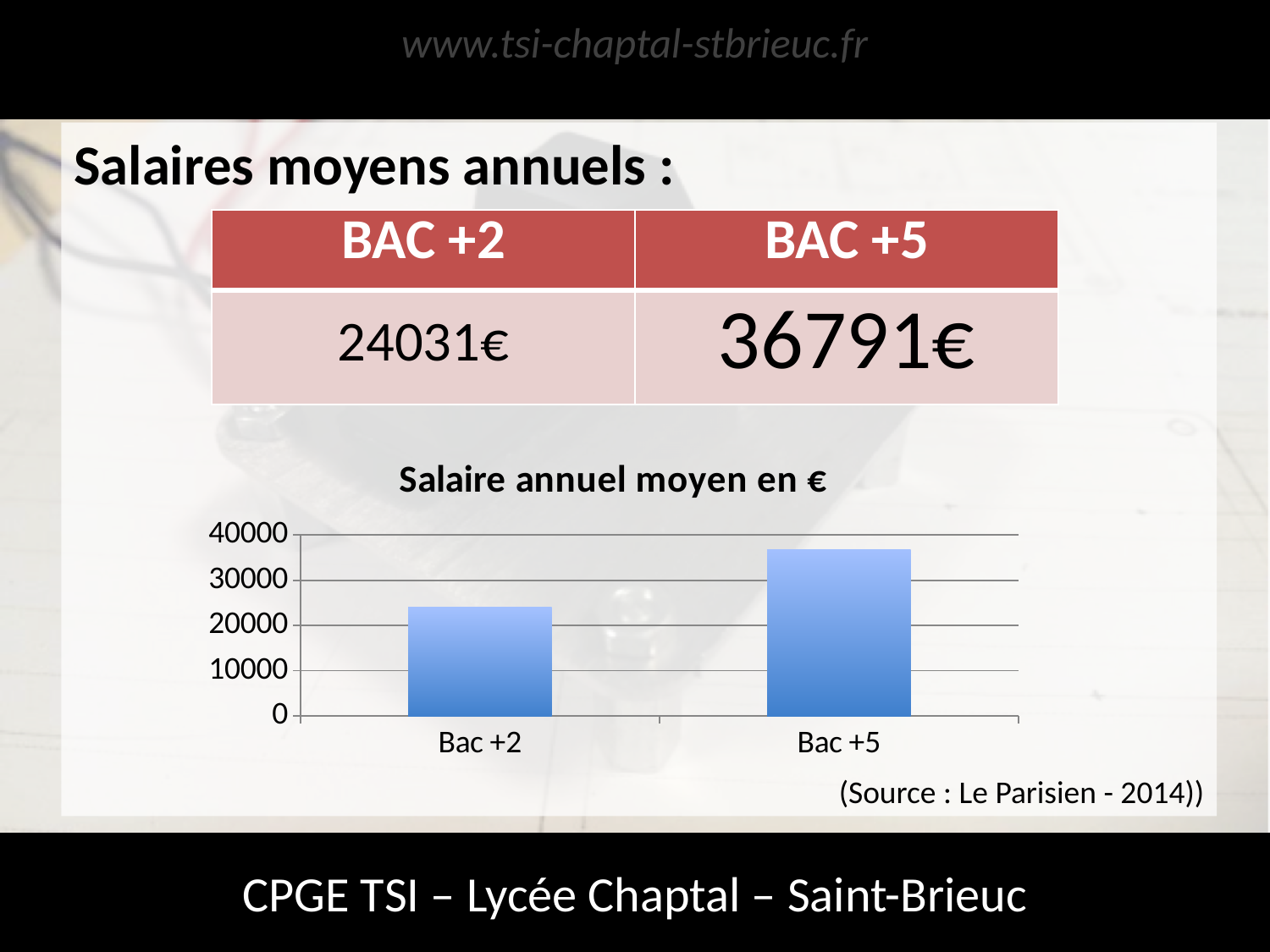
How many categories are plotted in the chart? 2 Is the value for Bac +2 greater or less than 20000? greater What is the title of the chart? Salaire annuel moyen en € Is the value for Bac +5 greater or less than 30000? greater According to the table on the slide, what is the average annual salary for BAC +5? 36791€ Which is larger, the value for Bac +2 or the value for Bac +5? Bac +5 Is the value for Bac +2 greater or less than 30000? less Which category has the highest bar in the chart? Bac +5 Which category has the lowest bar in the chart? Bac +2 What kind of chart is shown on the slide? bar chart According to the table on the slide, what is the average annual salary for BAC +2? 24031€